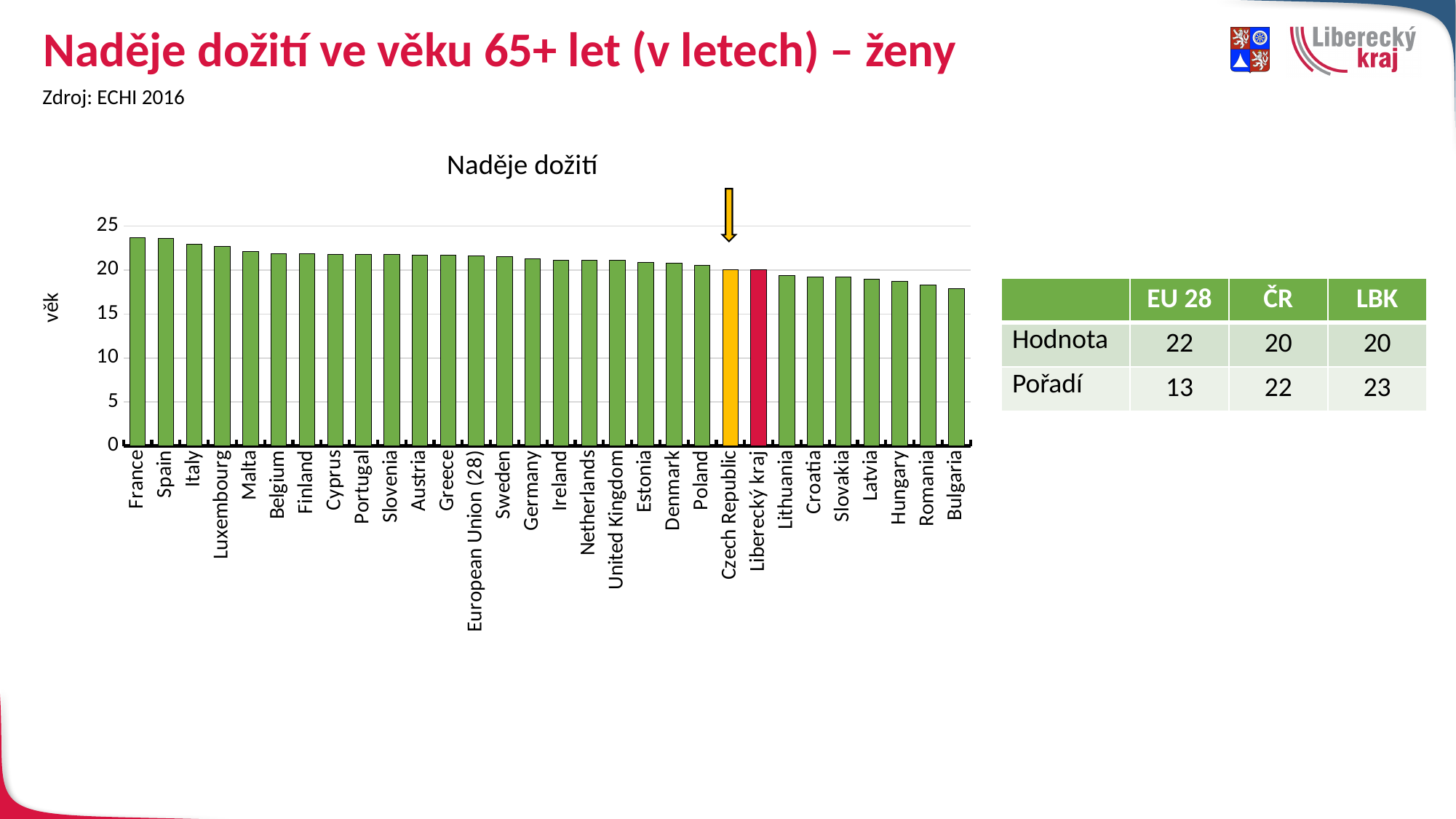
How many countries/regions are plotted on the chart? 30 Is the value for Lithuania greater or less than 20? less What colour is the bar for Czech Republic? orange Is the value for Bulgaria greater or less than 20? less What kind of chart is shown on the slide? bar chart What is the title of the chart? Naděje dožití Is the value for Italy greater or less than 20? greater Which has the higher value, Italy or Latvia? Italy Which has the higher value, France or Bulgaria? France Which category has the lowest value on the chart? Bulgaria Do the values rise or fall from left to right along the x axis? fall